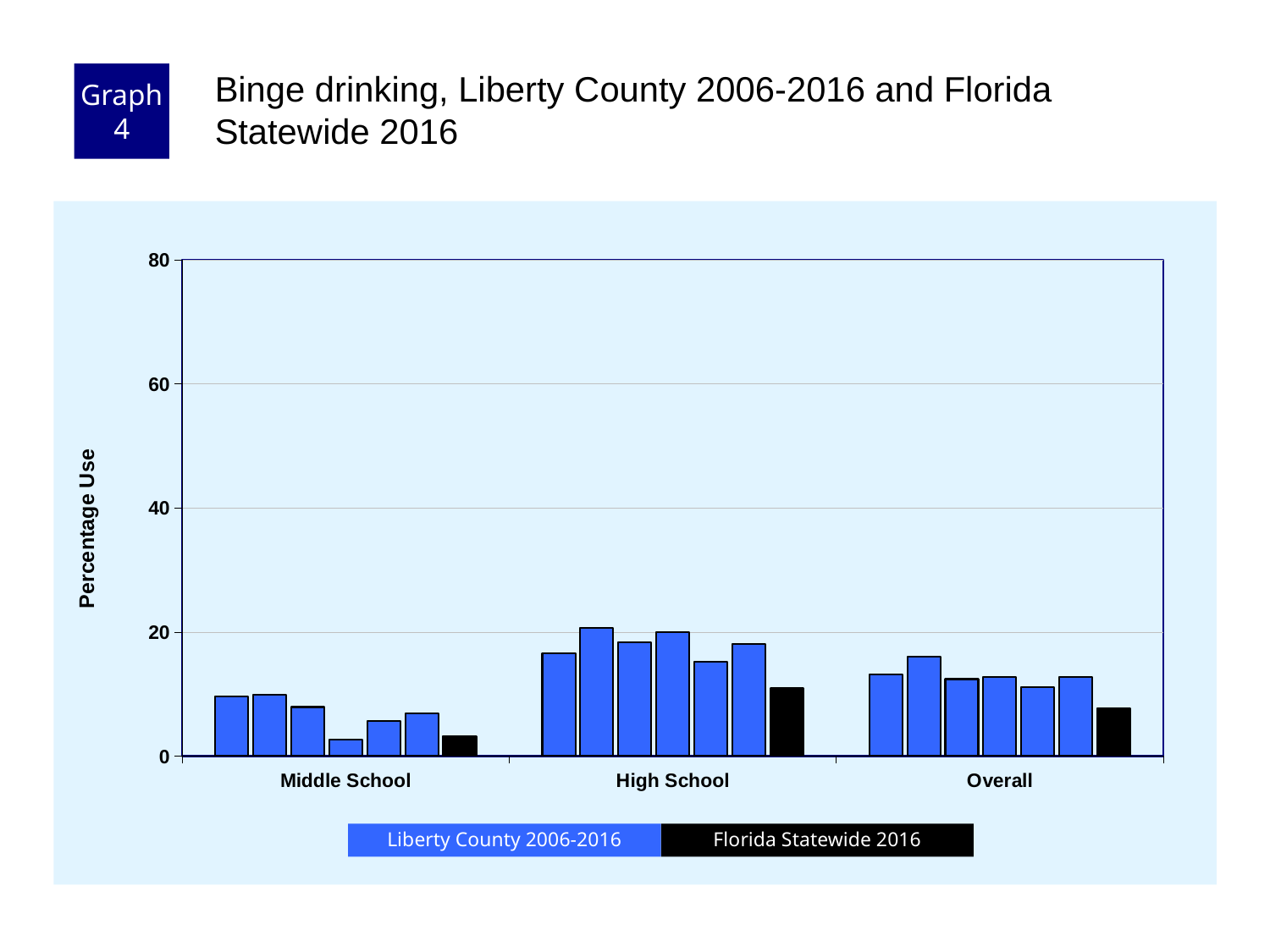
Which category has the lowest bars overall? Middle School Is the Florida Statewide 2016 value for Middle School greater or less than 20? less Which is larger, the Florida Statewide 2016 value for Overall or for Middle School? Overall What is the title of the chart? Binge drinking, Liberty County 2006-2016 and Florida Statewide 2016 Which category has the highest bars overall? High School Which is larger, the Florida Statewide 2016 value for High School or for Middle School? High School How many series does the legend list? 2 What is the label of the vertical axis? Percentage Use What kind of chart is shown on the slide? bar chart Are all the Liberty County 2006-2016 bars for Overall greater or less than 20? less Is the Florida Statewide 2016 value for High School greater or less than 20? less How many categories are shown on the x axis? 3